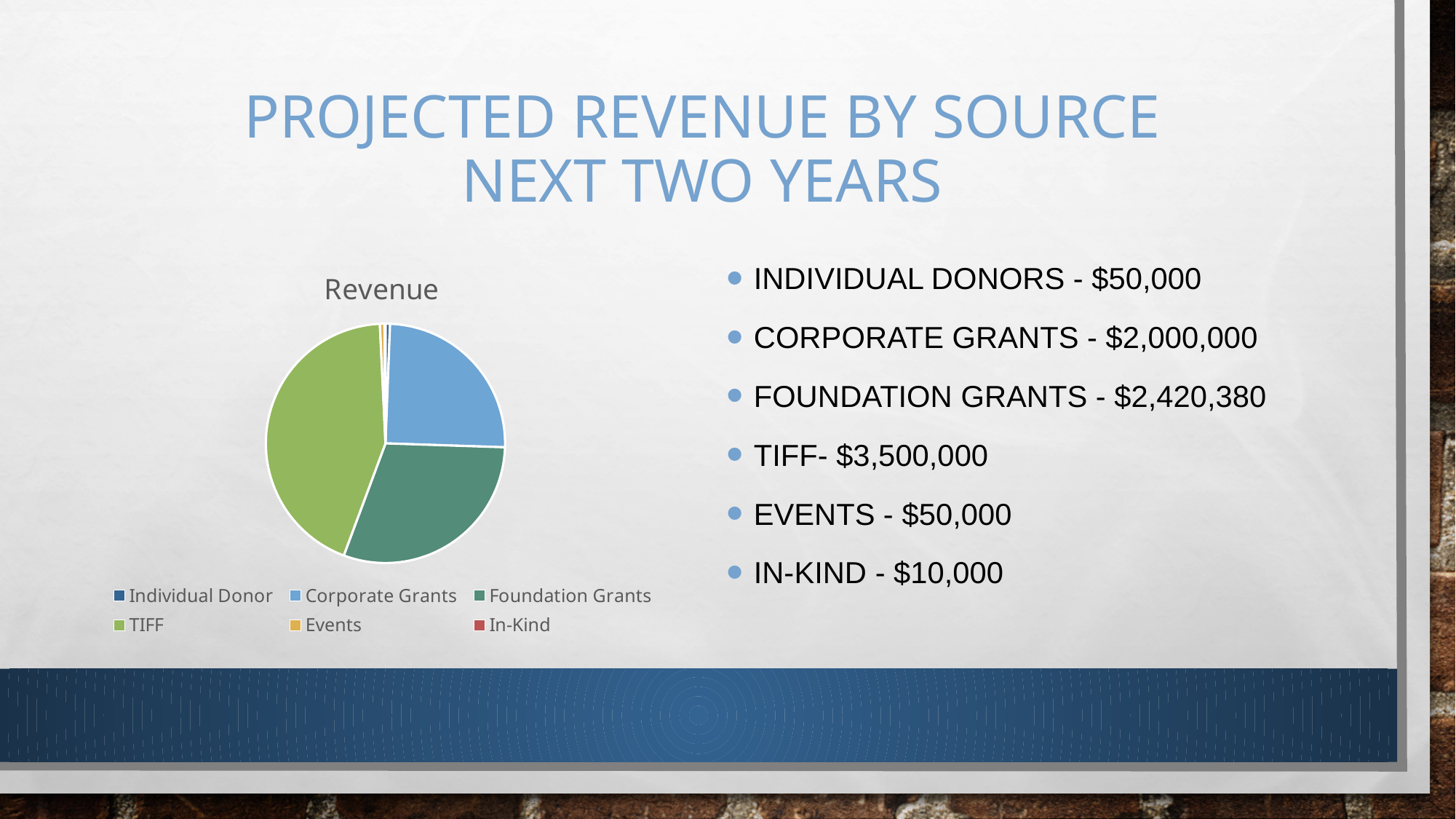
What is the difference between the TIFF revenue and the Foundation Grants revenue? $1,079,620 What colour is the TIFF slice in the pie chart? Green What is the projected revenue from Foundation Grants? $2,420,380 Which is larger, the TIFF slice or the Corporate Grants slice? TIFF What is the projected revenue from TIFF? $3,500,000 What kind of chart is shown on the slide? Pie chart Which revenue source has the largest slice of the pie? TIFF Which is larger, the Foundation Grants slice or the Corporate Grants slice? Foundation Grants What is the total projected revenue across all six sources? $8,030,380 What is the projected revenue from Corporate Grants? $2,000,000 What is the title of the chart? Revenue How many categories does the chart's legend list? 6